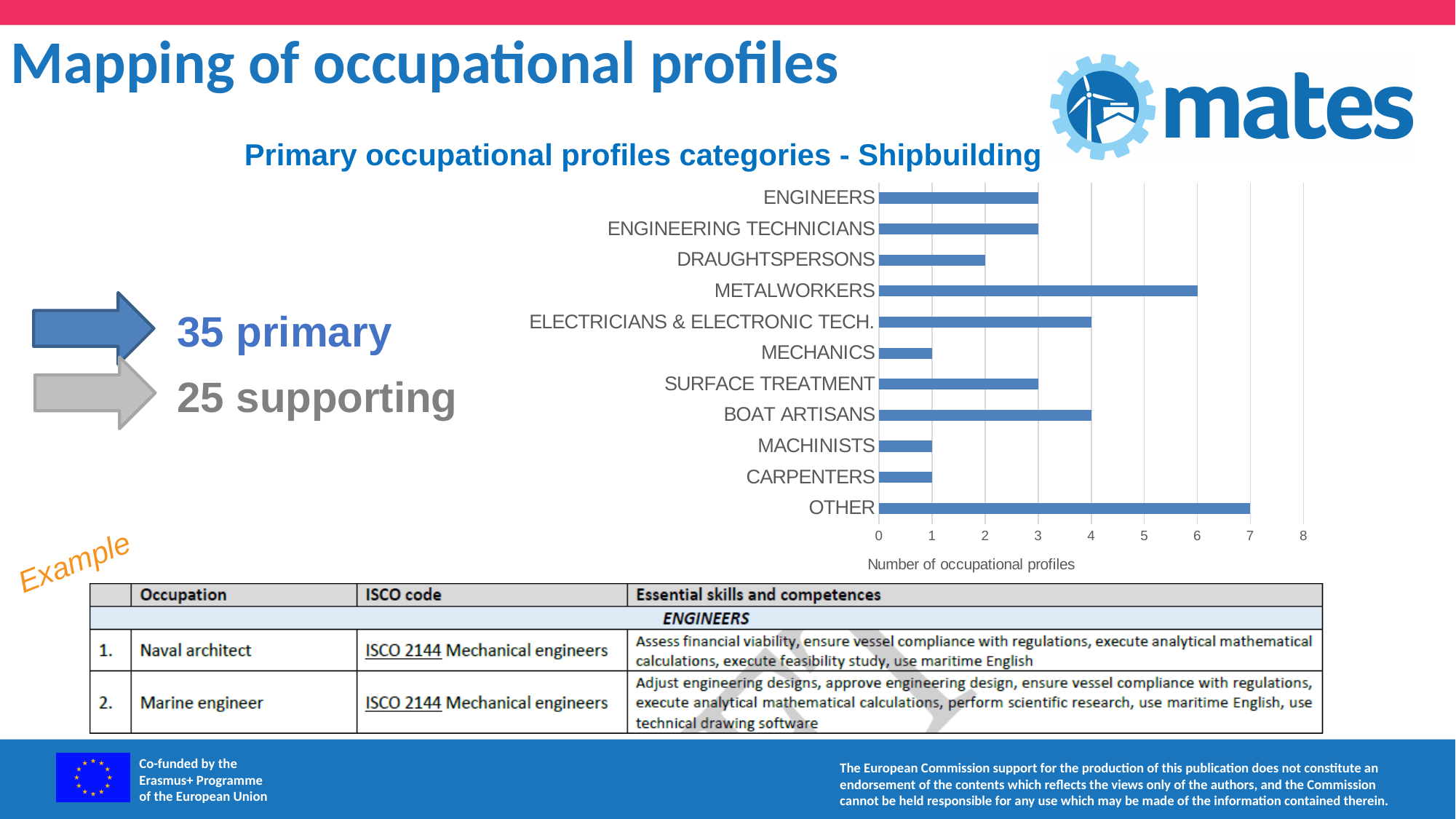
What is the number of occupational profiles for CARPENTERS? 1 Which category has more occupational profiles, METALWORKERS or ELECTRICIANS & ELECTRONIC TECH.? METALWORKERS What is the number of occupational profiles for BOAT ARTISANS? 4 What is the number of occupational profiles for METALWORKERS? 6 Which category has the highest number of occupational profiles? OTHER What is the difference between the number of occupational profiles for OTHER and for MECHANICS? 6 What type of chart is shown on the slide? bar chart Is the value for SURFACE TREATMENT greater or less than 5? less How many categories are plotted in the chart? 11 What is the label of the horizontal axis of the chart? Number of occupational profiles What is the title of the chart? Primary occupational profiles categories - Shipbuilding What is the number of occupational profiles for DRAUGHTSPERSONS? 2